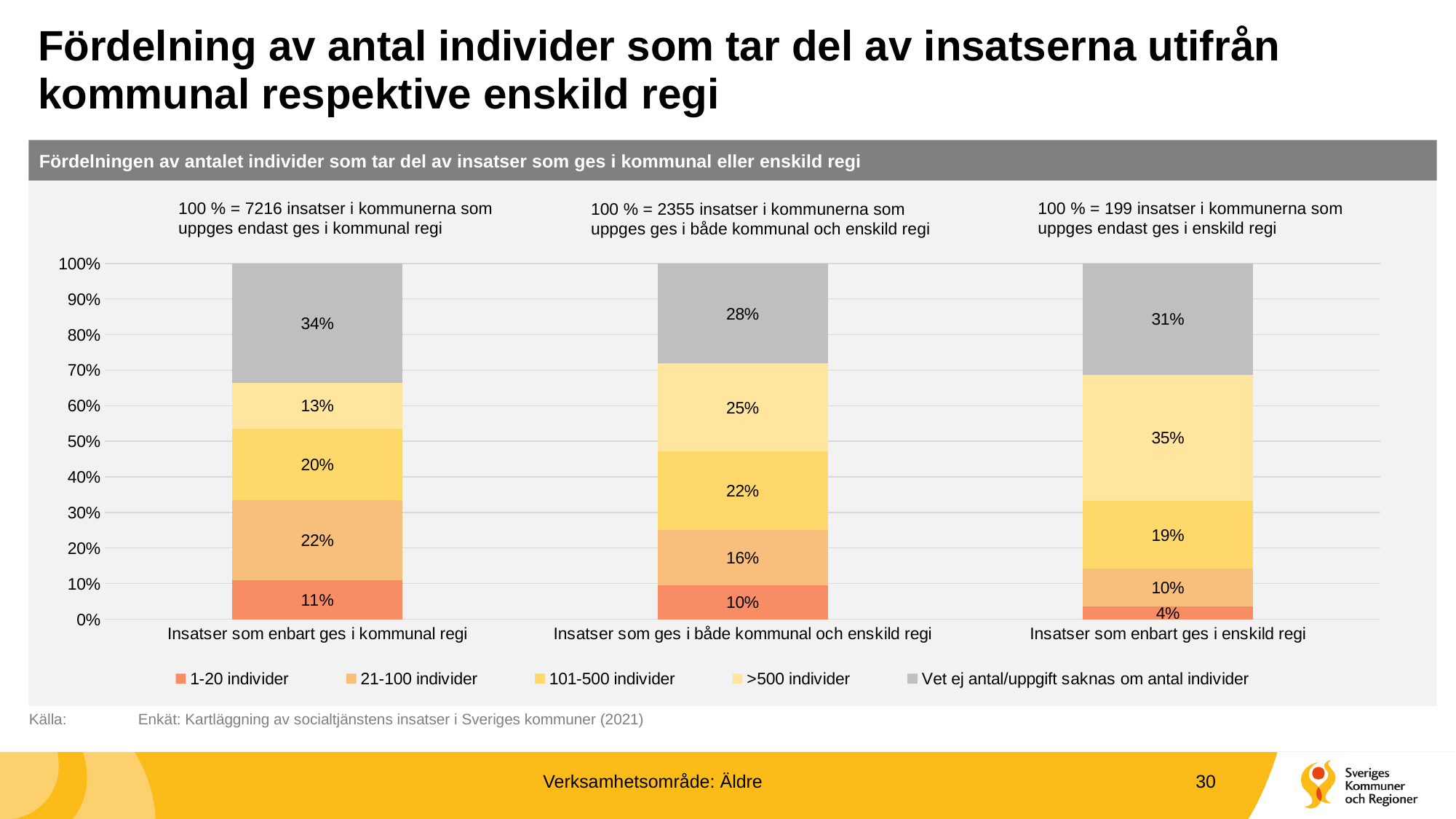
Which is larger: the "101-500 individer" value for "Insatser som ges i både kommunal och enskild regi" or for "Insatser som enbart ges i enskild regi"? Insatser som ges i både kommunal och enskild regi Which category has the lowest value for "1-20 individer"? Insatser som enbart ges i enskild regi According to the note above the chart, how many insatser does 100 % correspond to for the bar "Insatser som enbart ges i enskild regi"? 199 How many categories (bars) are shown on the x axis? 3 Which category has the highest value for ">500 individer"? Insatser som enbart ges i enskild regi What is the value for "1-20 individer" in the bar "Insatser som ges i både kommunal och enskild regi"? 10% What is the value for ">500 individer" in the bar "Insatser som enbart ges i enskild regi"? 35% What percentage of the bar for "Insatser som enbart ges i kommunal regi" is "Vet ej antal/uppgift saknas om antal individer"? 34% What kind of chart is shown on the slide? Stacked bar chart What is the value for "21-100 individer" in the bar "Insatser som enbart ges i kommunal regi"? 22% How many series does the legend list? 5 What is the difference between the "Vet ej antal/uppgift saknas om antal individer" values for "Insatser som enbart ges i kommunal regi" and "Insatser som ges i både kommunal och enskild regi"? 6 percentage points